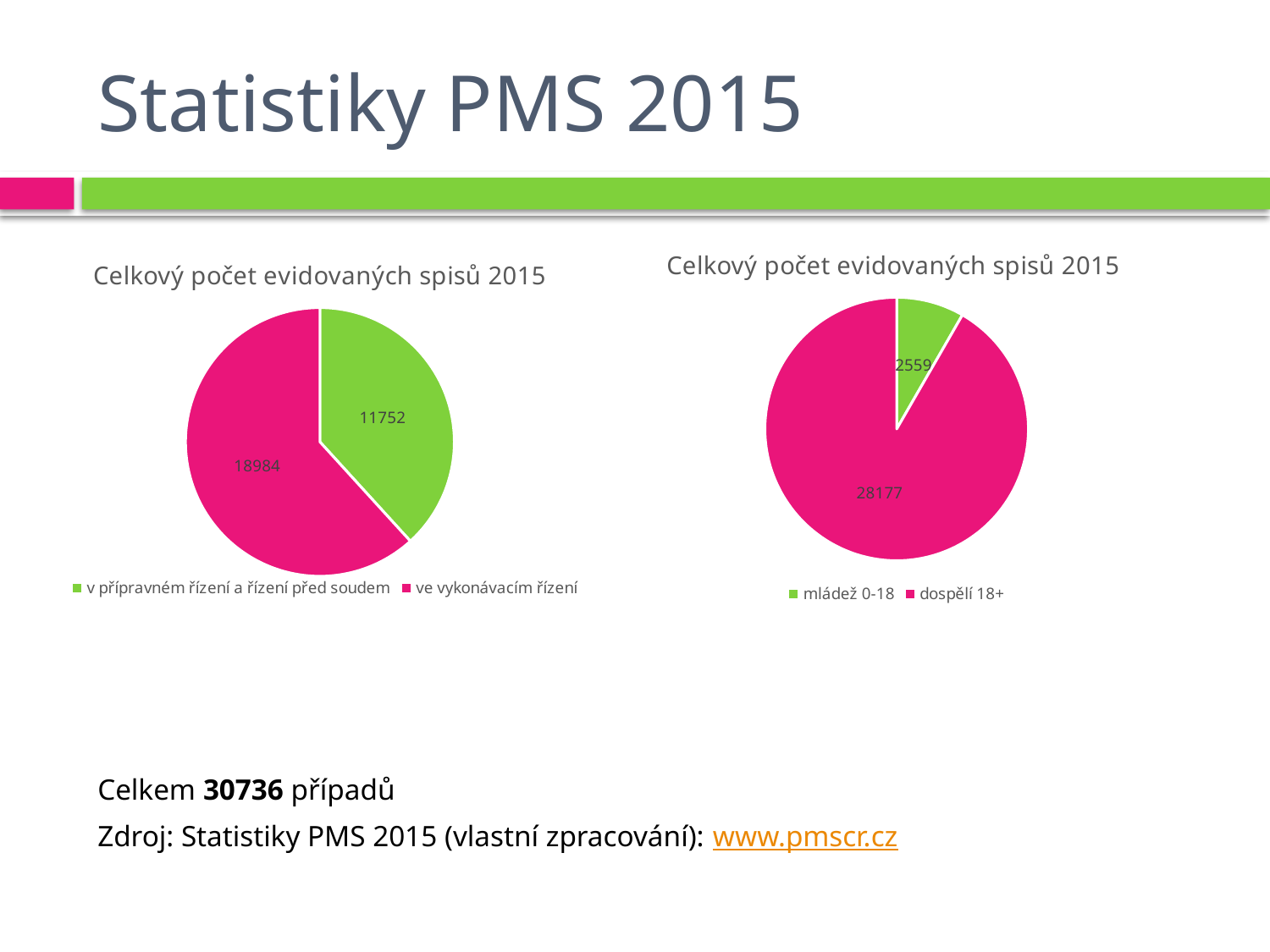
What type of chart is the right chart on the slide? Pie chart In the right pie chart, what is the difference between 'dospělí 18+' and 'mládež 0-18'? 25618 In the right pie chart, what is the value for 'mládež 0-18'? 2559 What colour is the 'mládež 0-18' slice in the right pie chart? Green In the left pie chart, what is the value for 've vykonávacím řízení'? 18984 In the left pie chart, what is the difference between 've vykonávacím řízení' and 'v přípravném řízení a řízení před soudem'? 7232 In the left pie chart, what is the value for 'v přípravném řízení a řízení před soudem'? 11752 How many categories does the left pie chart show? 2 In the right pie chart, what is the value for 'dospělí 18+'? 28177 In the right pie chart, which category has the smaller value? mládež 0-18 In the left pie chart, which category has the larger value? ve vykonávacím řízení